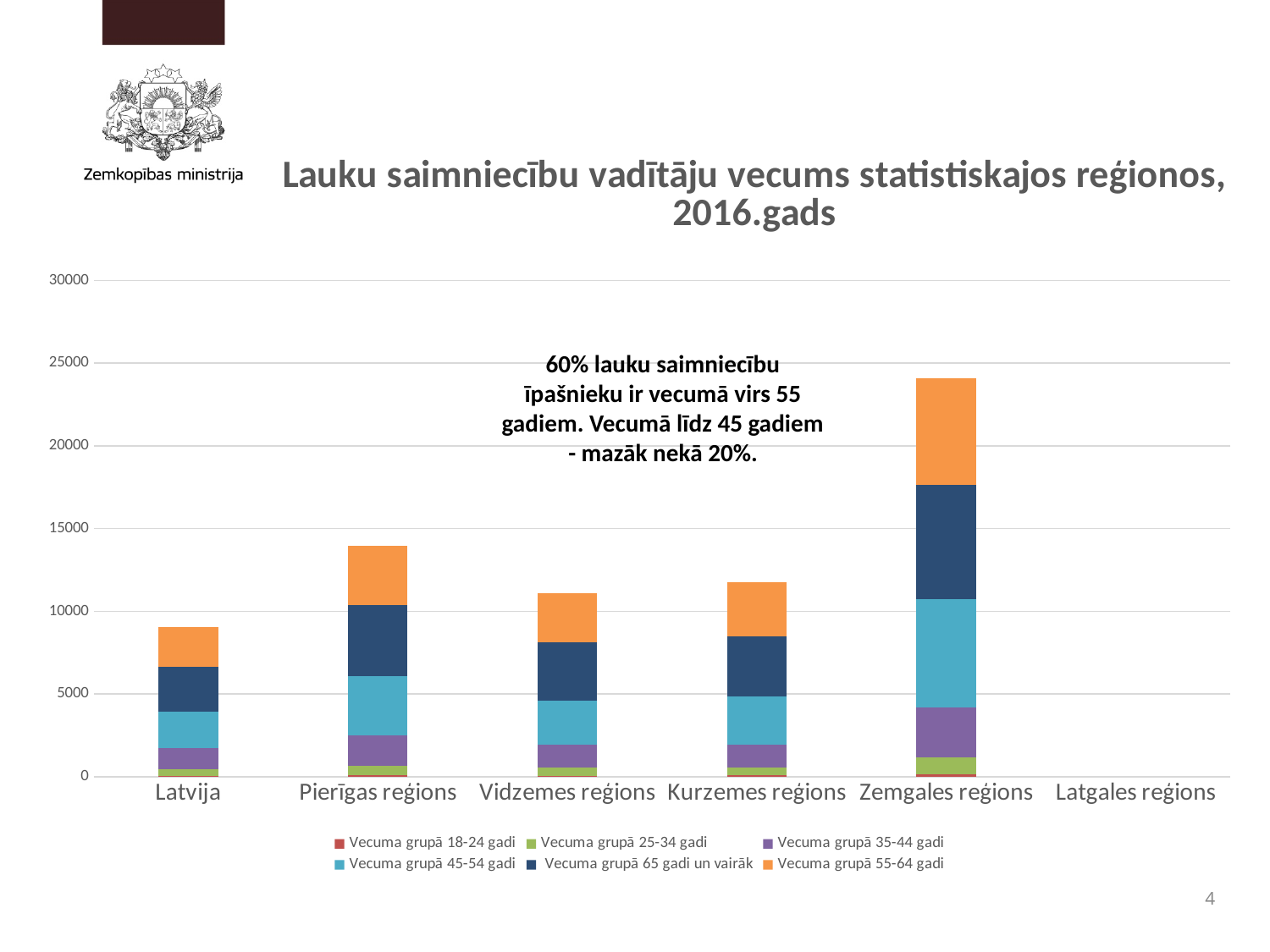
What kind of chart is shown on the slide? Stacked bar chart Which bar is taller, Pierīgas reģions or Vidzemes reģions? Pierīgas reģions Is the total value of the bar for Kurzemes reģions greater or less than 15000? less Is the total value of the bar for Latvija greater or less than 10000? less What is the title of the chart? Lauku saimniecību vadītāju vecums statistiskajos reģionos, 2016.gads Which region has the tallest stacked bar? Zemgales reģions How many series does the legend list? 6 Is the total value of the bar for Pierīgas reģions greater or less than 10000? greater How many categories are shown on the x axis? 6 Which bar is taller, Zemgales reģions or Pierīgas reģions? Zemgales reģions Which age group series is shown in orange in the legend? Vecuma grupā 55-64 gadi